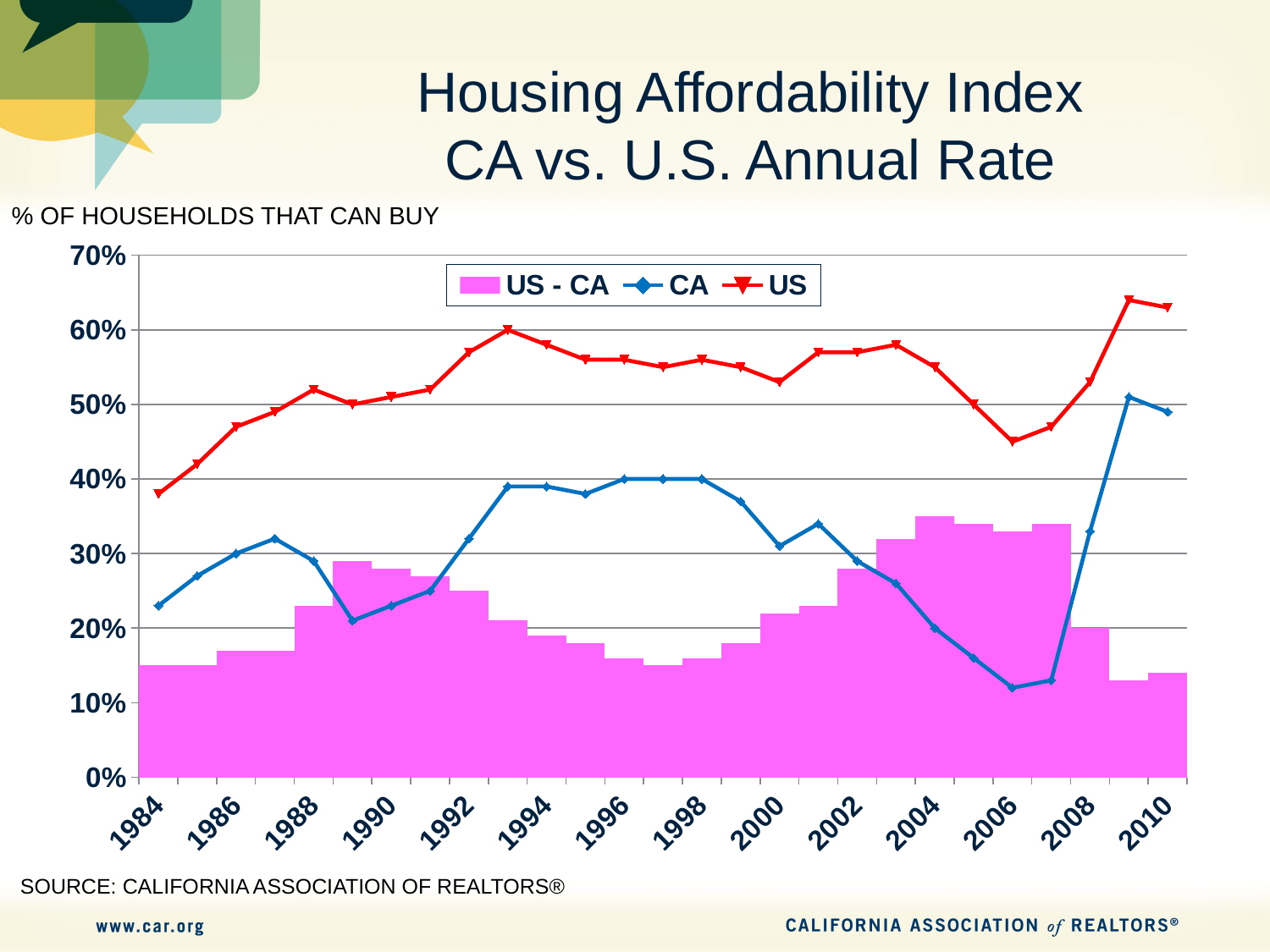
What kind of chart is shown on the slide? A combined bar and line chart How many series does the legend list? 3 What is the value of the CA series in 1997? 40% In which year does the CA series reach its lowest value? 2006 What are the three series named in the legend? US - CA, CA, US Is the US - CA bar for 2004 greater or less than 30%? greater Which series has the higher value in 2000, CA or US? US In which year is the US series at its lowest value? 1984 Does the CA series rise or fall from 2006 to 2009? rise In which year does the US series reach its highest value? 2009 Is the value of the CA series in 2006 greater or less than 20%? less Is the value of the US series in 2009 greater or less than 60%? greater